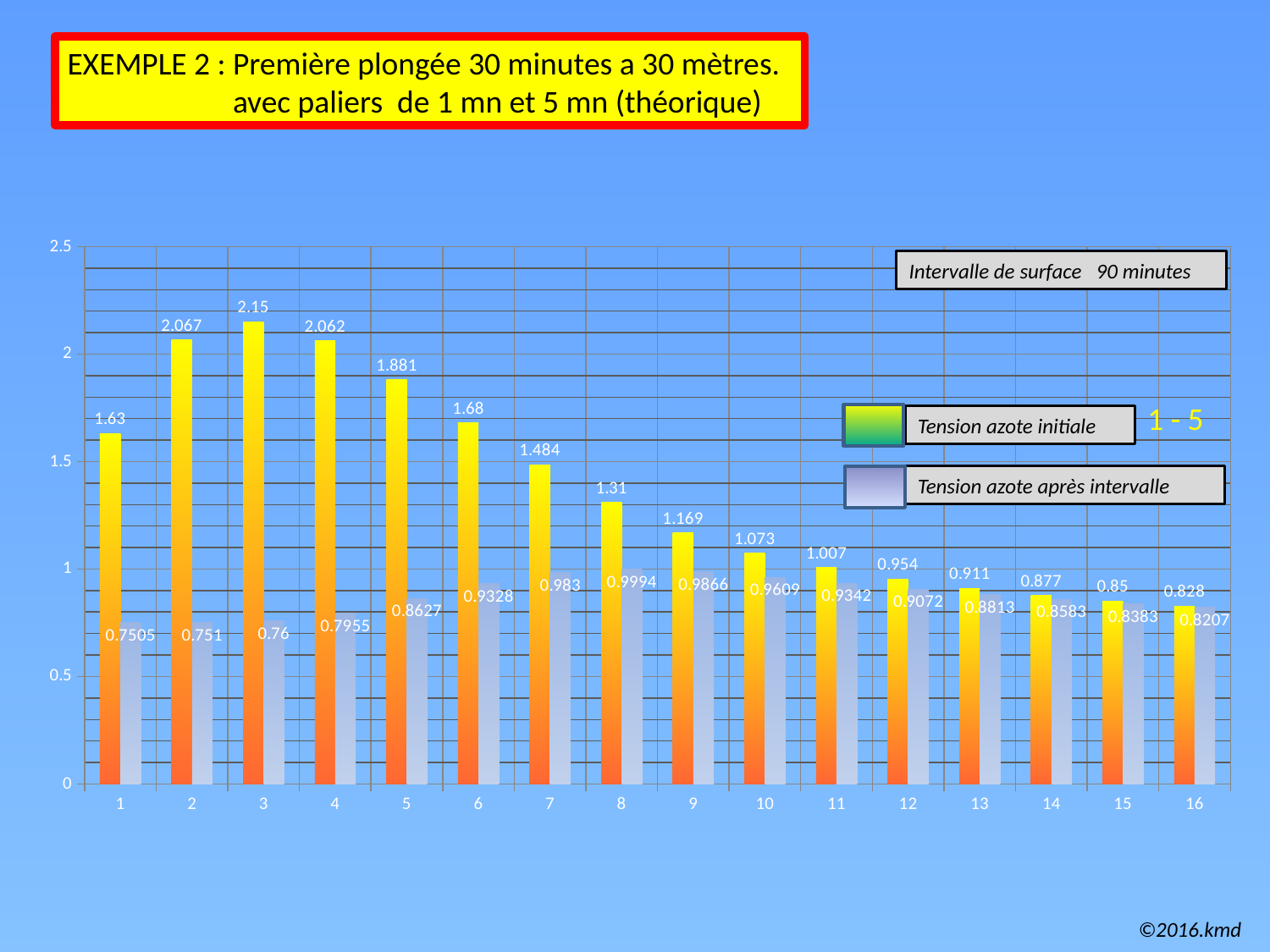
Which category has the highest 'Tension azote initiale' value? 3 Is the 'Tension azote initiale' value for category 5 greater or less than 1.5? greater How many series does the legend list? 2 For category 9, which is larger: 'Tension azote initiale' or 'Tension azote après intervalle'? Tension azote initiale What is the 'Tension azote après intervalle' value for category 8? 0.9994 What is the 'Tension azote initiale' value for category 16? 0.828 How many categories are shown on the x axis? 16 Which category has the lowest 'Tension azote après intervalle' value? 1 What is the 'Tension azote initiale' value for category 3? 2.15 What surface interval is stated in the box on the chart? 90 minutes What kind of chart is shown on the slide? bar chart What is the difference between the 'Tension azote initiale' value for category 1 and its 'Tension azote après intervalle' value? 0.8795